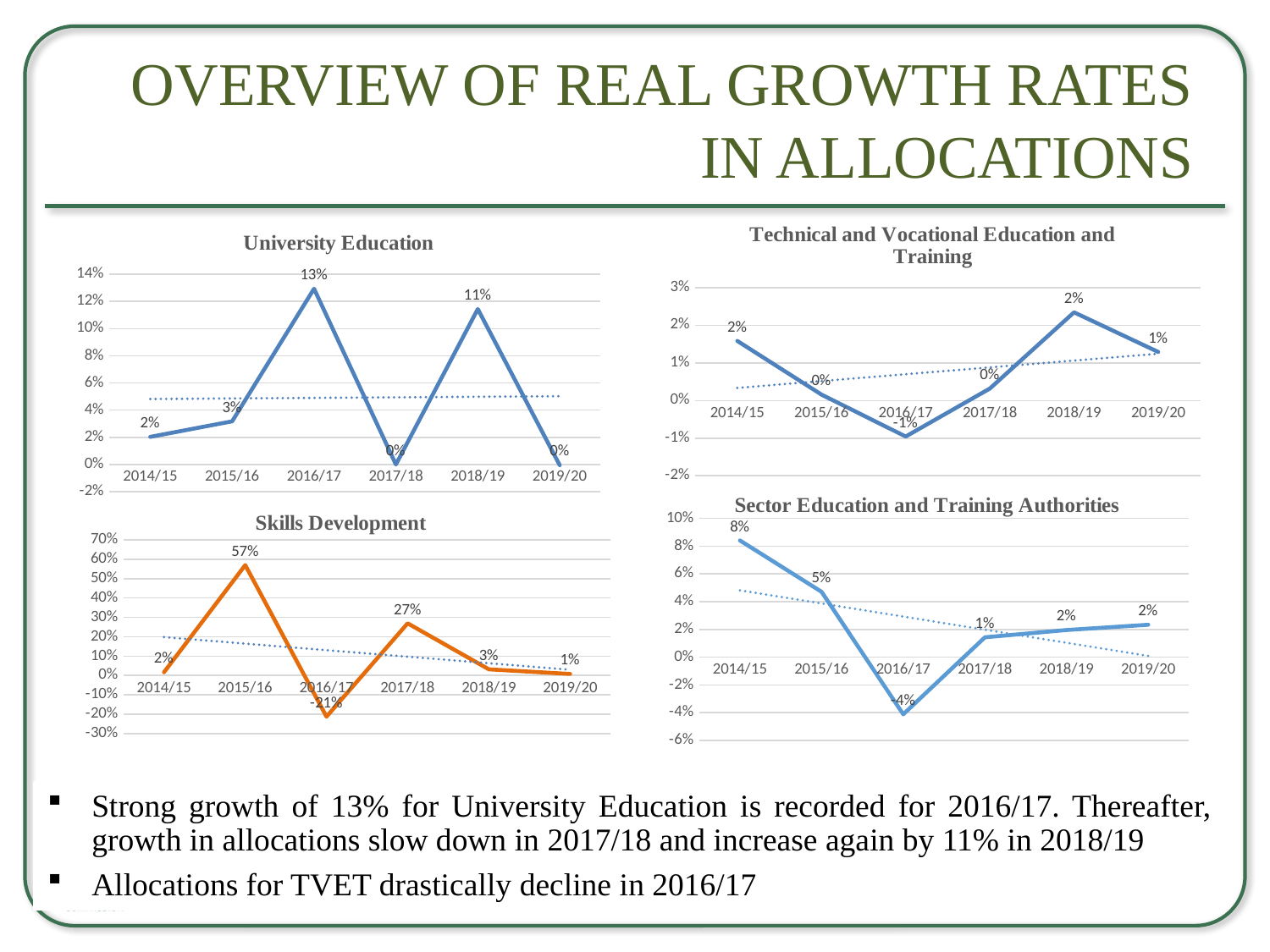
What kind of chart is the Skills Development chart? Line chart In the Skills Development chart, which year has the lowest value? 2016/17 In the Technical and Vocational Education and Training chart, what is the value for 2016/17? -1% In the Sector Education and Training Authorities chart, which is larger, the value for 2014/15 or the value for 2015/16? 2014/15 In the Sector Education and Training Authorities chart, which year has the lowest value? 2016/17 In the Skills Development chart, what is the value for 2015/16? 57% How many years are plotted in the University Education chart? 6 In the Sector Education and Training Authorities chart, what is the value for 2014/15? 8% In the Sector Education and Training Authorities chart, do the values rise or fall from 2014/15 to 2016/17? Fall In the Skills Development chart, what is the difference between the values for 2015/16 and 2017/18? 30% In the University Education chart, what is the value for 2016/17? 13% In the University Education chart, which year has the highest value? 2016/17